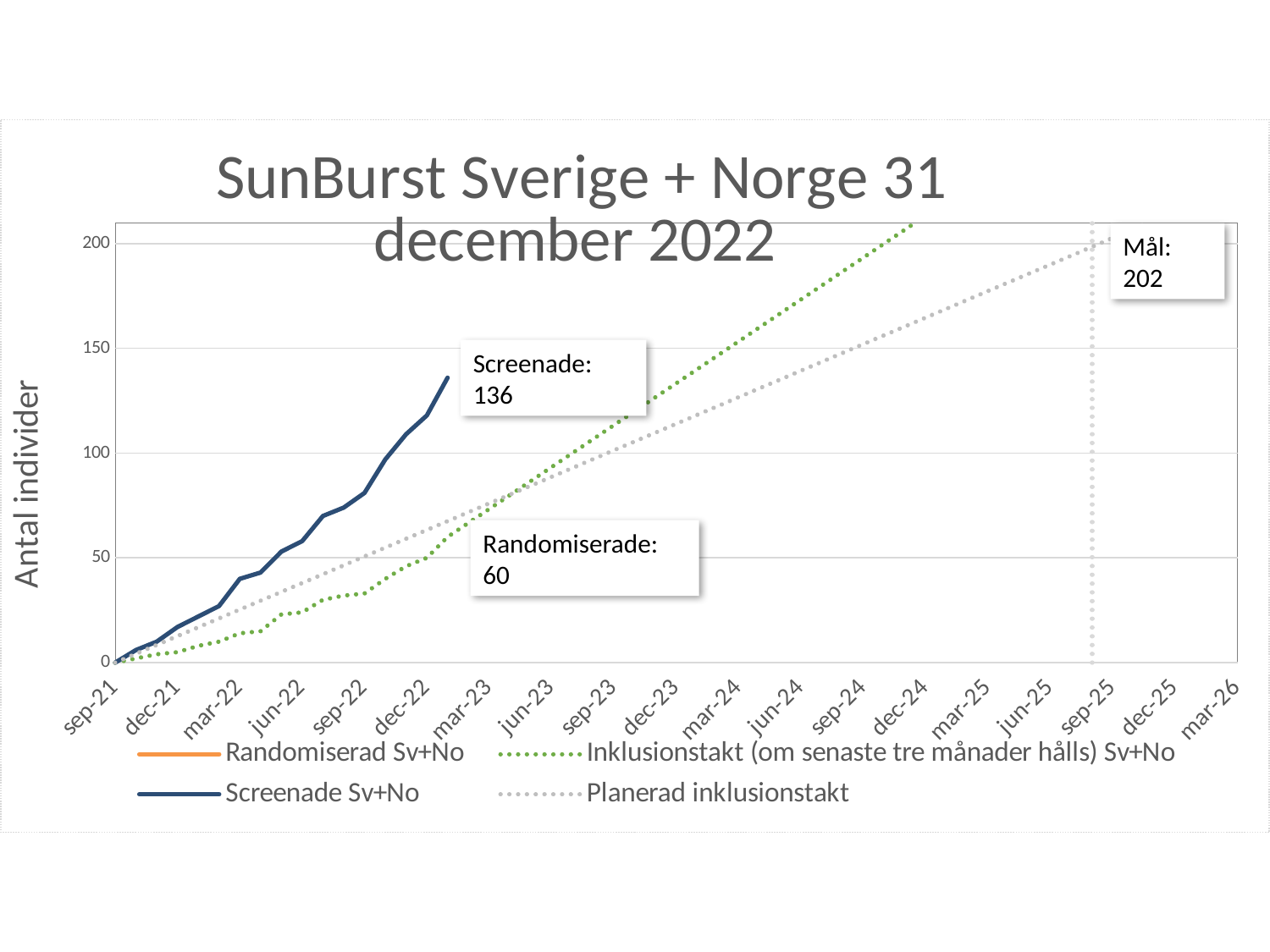
What is the number of Randomiserade shown in the annotation on the chart? 60 How many date labels are shown on the x axis? 19 Which series is drawn as a grey dotted line? Planerad inklusionstakt Is the value of Planerad inklusionstakt at mar-23 greater or less than 100? less Is the value of Screenade Sv+No at dec-22 greater or less than 100? greater What is the value of Mål (the target) shown on the chart? 202 What is the title of the chart? SunBurst Sverige + Norge 31 december 2022 What is the difference between the Screenade value (136) and the Randomiserade value (60)? 76 How many series does the legend list? 4 What is the number of Screenade shown in the annotation on the chart? 136 Does the Screenade Sv+No line rise or fall from sep-21 to dec-22? rise What kind of chart is shown on the slide? line chart